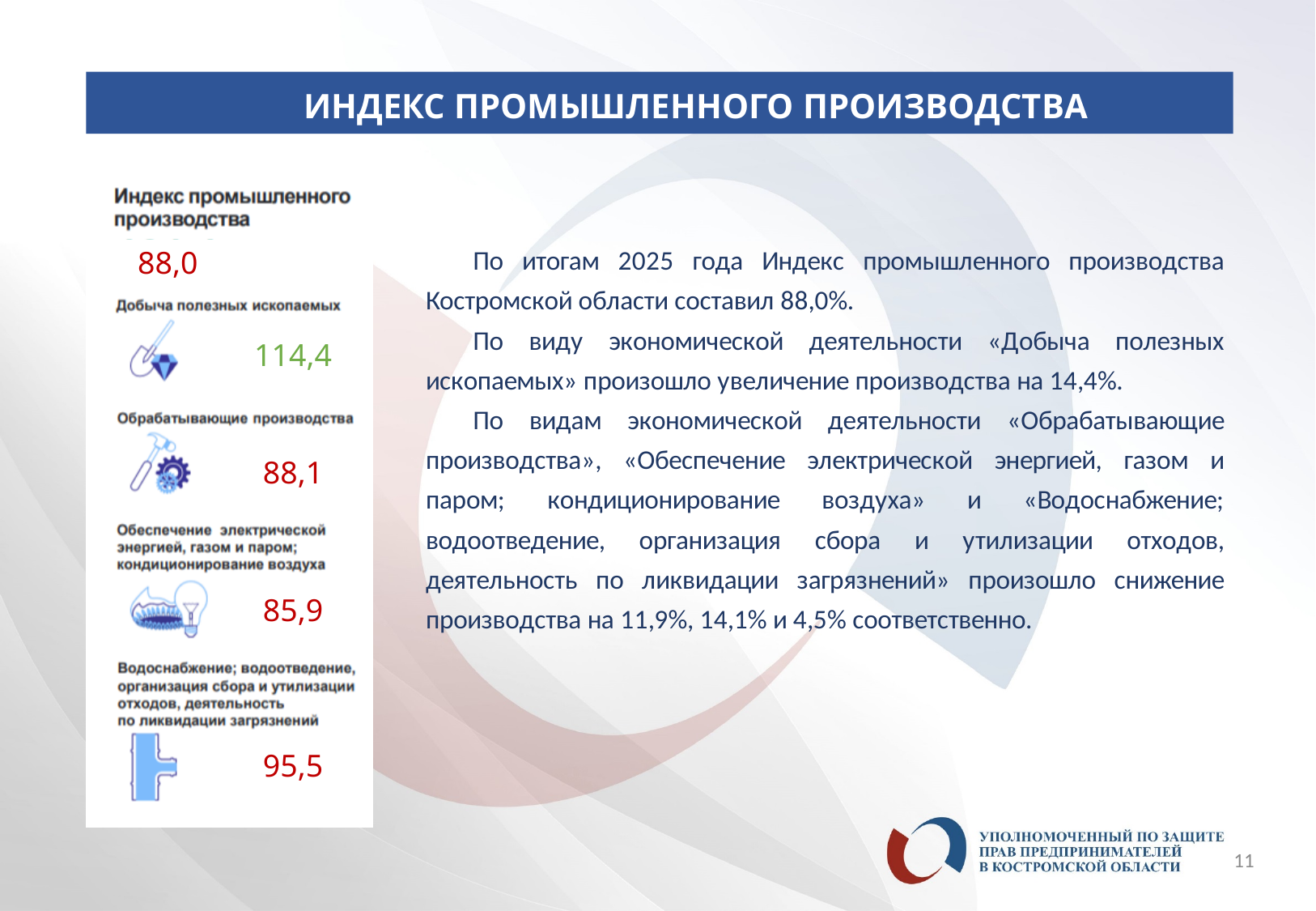
Which type of economic activity has the lowest index value in the infographic? Обеспечение электрической энергией, газом и паром; кондиционирование воздуха Which value in the infographic is printed in green rather than red? 114,4 Which type of economic activity has the highest index value in the infographic? Добыча полезных ископаемых How many types of economic activity are listed in the infographic below the overall index? 4 What value is shown for «Водоснабжение; водоотведение, организация сбора и утилизации отходов, деятельность по ликвидации загрязнений»? 95,5 What value is shown for «Обеспечение электрической энергией, газом и паром; кондиционирование воздуха»? 85,9 What value is shown for «Добыча полезных ископаемых»? 114,4 What is the overall industrial production index shown at the top of the infographic? 88,0 What is the difference between the index for «Водоснабжение; водоотведение...» and the index for «Обрабатывающие производства»? 7,4 Which is larger: the index for «Обрабатывающие производства» or the index for «Водоснабжение; водоотведение...»? Водоснабжение; водоотведение... What is the difference between the index for «Добыча полезных ископаемых» and the index for «Обеспечение электрической энергией, газом и паром; кондиционирование воздуха»? 28,5 What value is shown for «Обрабатывающие производства»? 88,1